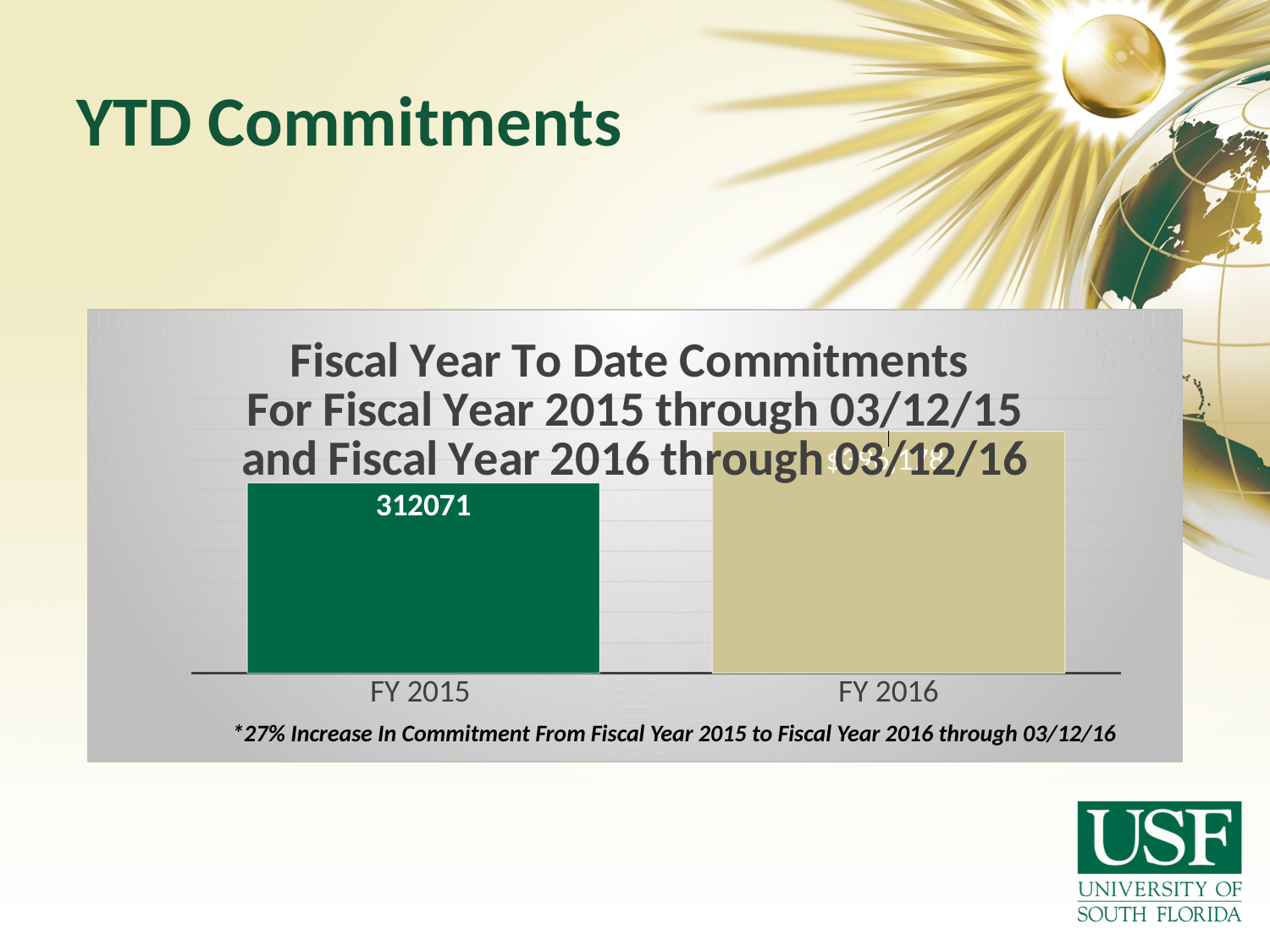
What percentage increase in commitment from Fiscal Year 2015 to Fiscal Year 2016 does the footnote state? 27% What colour is the bar for FY 2015? green Which fiscal year has the lower commitment value? FY 2015 Do the values rise or fall from FY 2015 to FY 2016? rise What kind of chart is shown on the slide? bar chart How many categories are plotted on the chart? 2 What are the two category labels on the x axis? FY 2015 and FY 2016 What is the value shown for FY 2015? 312071 Which fiscal year has the higher commitment value? FY 2016 Is the bar for FY 2016 taller or shorter than the bar for FY 2015? taller